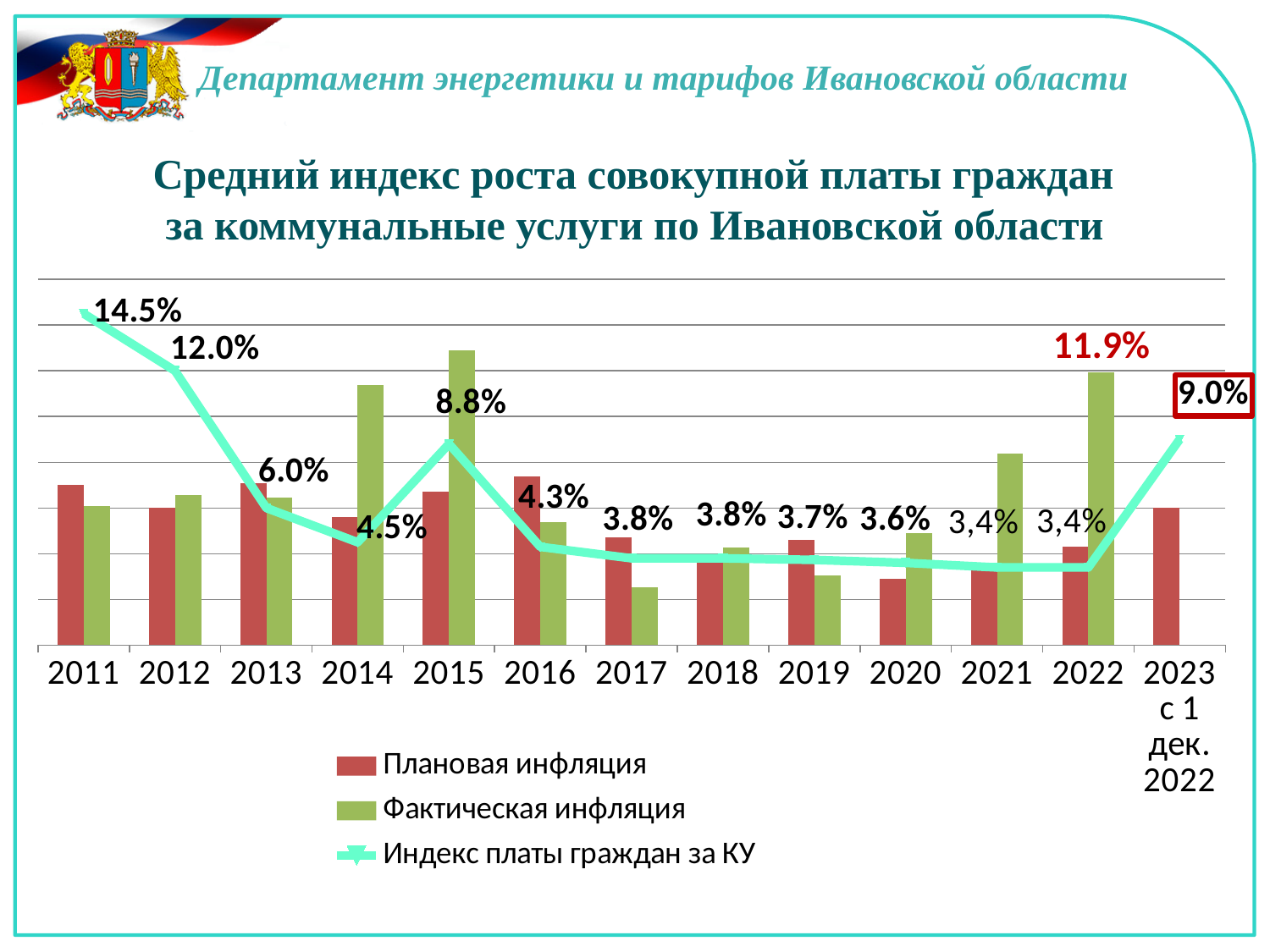
What is the value of the 'Индекс платы граждан за КУ' line for 2020? 3.6% What is the value of the 'Индекс платы граждан за КУ' line for 2011? 14.5% How many years (categories) are shown on the x axis? 13 Which year has the larger 'Индекс платы граждан за КУ' value, 2015 or 2016? 2015 What is the difference between the 'Индекс платы граждан за КУ' values for 2011 and 2012? 2.5% What is the value of the 'Индекс платы граждан за КУ' line for 2015? 8.8% What is the value of the 'Индекс платы граждан за КУ' line for 2023 (с 1 дек. 2022)? 9.0% In 2014, which bar is taller: 'Плановая инфляция' or 'Фактическая инфляция'? Фактическая инфляция Does the 'Индекс платы граждан за КУ' line rise or fall from 2011 to 2014? fall How many series does the legend list? 3 In which year is the 'Индекс платы граждан за КУ' line highest? 2011 In 2017, which bar is taller: 'Плановая инфляция' or 'Фактическая инфляция'? Плановая инфляция